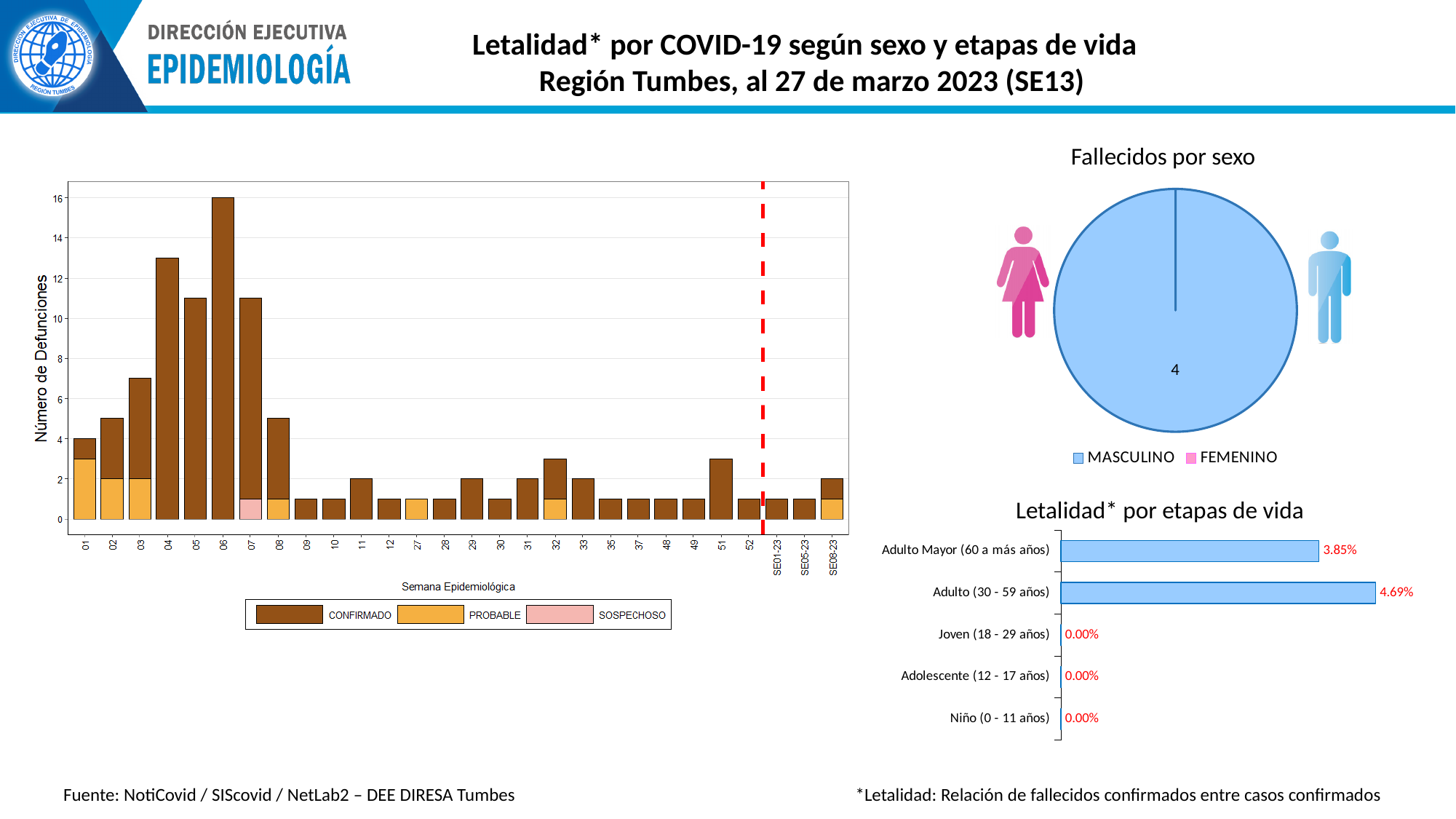
In the 'Letalidad* por etapas de vida' chart, what is the value for Adulto (30 - 59 años)? 4.69% In the 'Número de Defunciones' chart on the left, what is the total number of deaths in week 06? 16 In the 'Número de Defunciones' chart on the left, which epidemiological week has the highest number of deaths? 06 What kind of chart is the 'Fallecidos por sexo' chart? Pie chart In the 'Fallecidos por sexo' pie chart, what value is printed on the slice? 4 In the 'Número de Defunciones' chart on the left, is the total for week 04 greater or less than 12? greater In the 'Letalidad* por etapas de vida' chart, what is the difference between the values for Adulto (30 - 59 años) and Adulto Mayor (60 a más años)? 0.84% In the 'Fallecidos por sexo' pie chart, how many entries does the legend list? 2 In the 'Letalidad* por etapas de vida' chart, which age group has the highest lethality? Adulto (30 - 59 años) In the 'Letalidad* por etapas de vida' chart, what is the value for Adulto Mayor (60 a más años)? 3.85% In the 'Letalidad* por etapas de vida' chart, how many age groups are shown? 5 In the 'Letalidad* por etapas de vida' chart, what is the value for Joven (18 - 29 años)? 0.00%